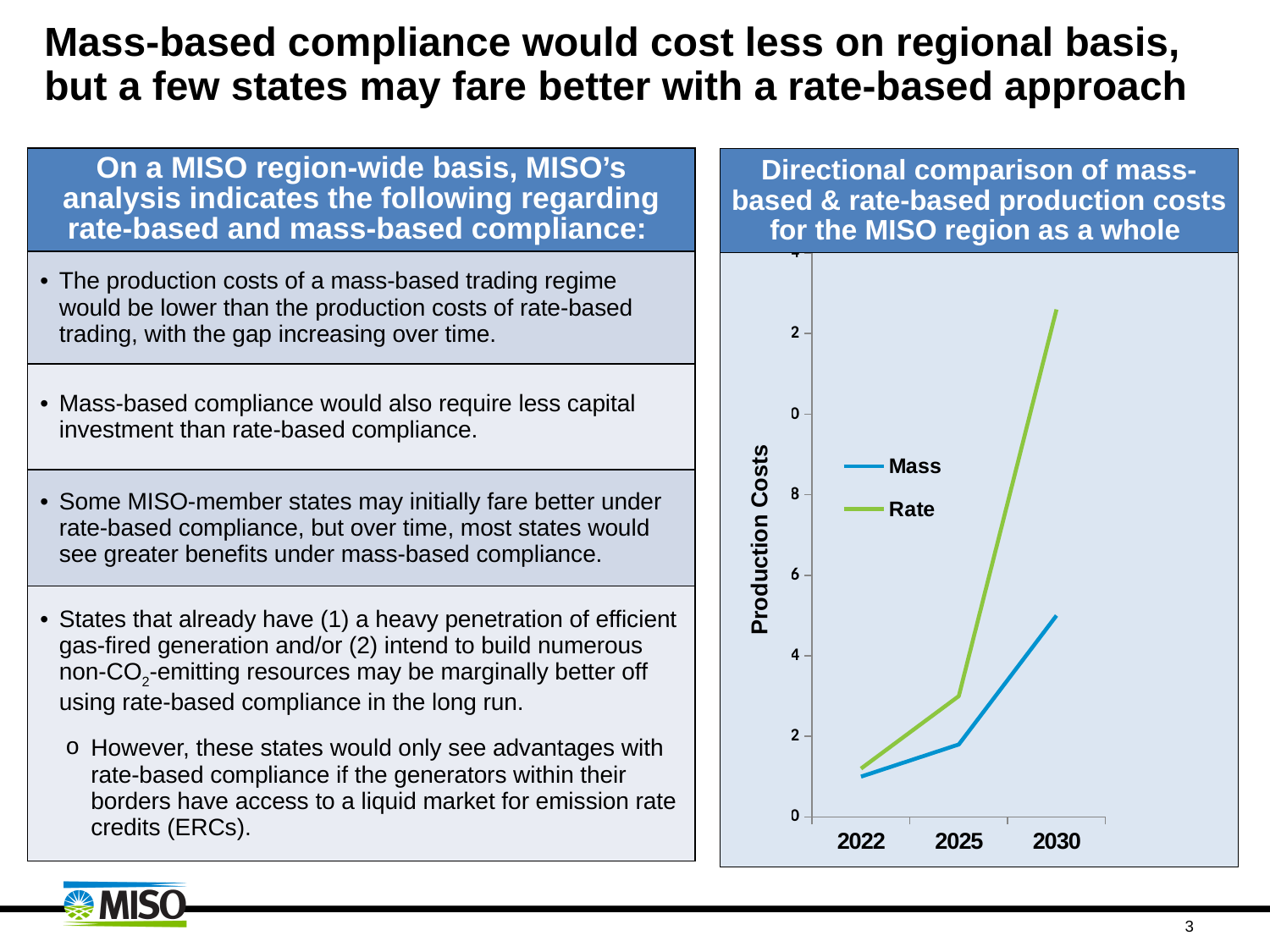
What is the label on the y axis of the chart? Production Costs Is the value for Rate in 2030 greater or less than 8? greater In 2030, which series has the higher production cost, Mass or Rate? Rate What are the two series named in the chart legend? Mass and Rate Is the value for Mass in 2022 greater or less than 2? less In 2025, which series has the higher production cost, Mass or Rate? Rate How many series does the chart legend list? 2 What kind of chart is shown on the slide? Line chart Does the Mass series rise or fall from 2022 to 2030? Rise Is the value for Mass in 2030 greater or less than 4? greater Does the Rate series rise or fall from 2022 to 2030? Rise How many years are plotted along the x axis of the chart? 3